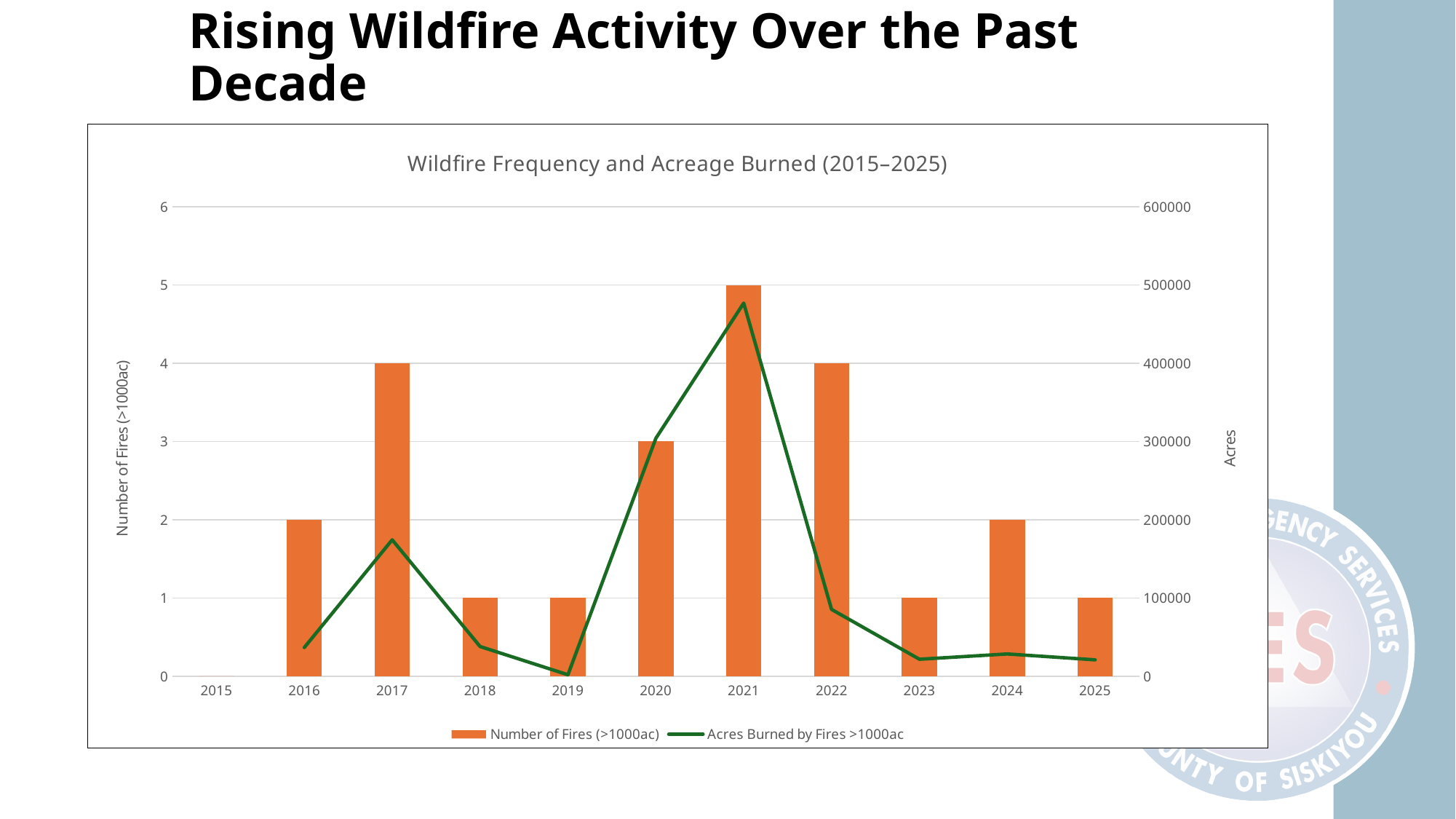
Is the value for acres burned by fires >1000ac in 2023 greater or less than 100000? less How many years are shown on the x axis of the chart? 11 What is the difference in the number of fires (>1000ac) between 2021 and 2024? 3 Which year has the highest number of fires (>1000ac)? 2021 What kind of chart is shown on the slide? Combined bar and line chart What is the number of fires (>1000ac) in 2021? 5 How many series does the legend list? 2 What is the number of fires (>1000ac) in 2017? 4 What is the title of the chart? Wildfire Frequency and Acreage Burned (2015–2025) What is the number of fires (>1000ac) in 2020? 3 Is the value for acres burned by fires >1000ac in 2021 greater or less than 400000? greater Which year has more fires (>1000ac), 2016 or 2022? 2022